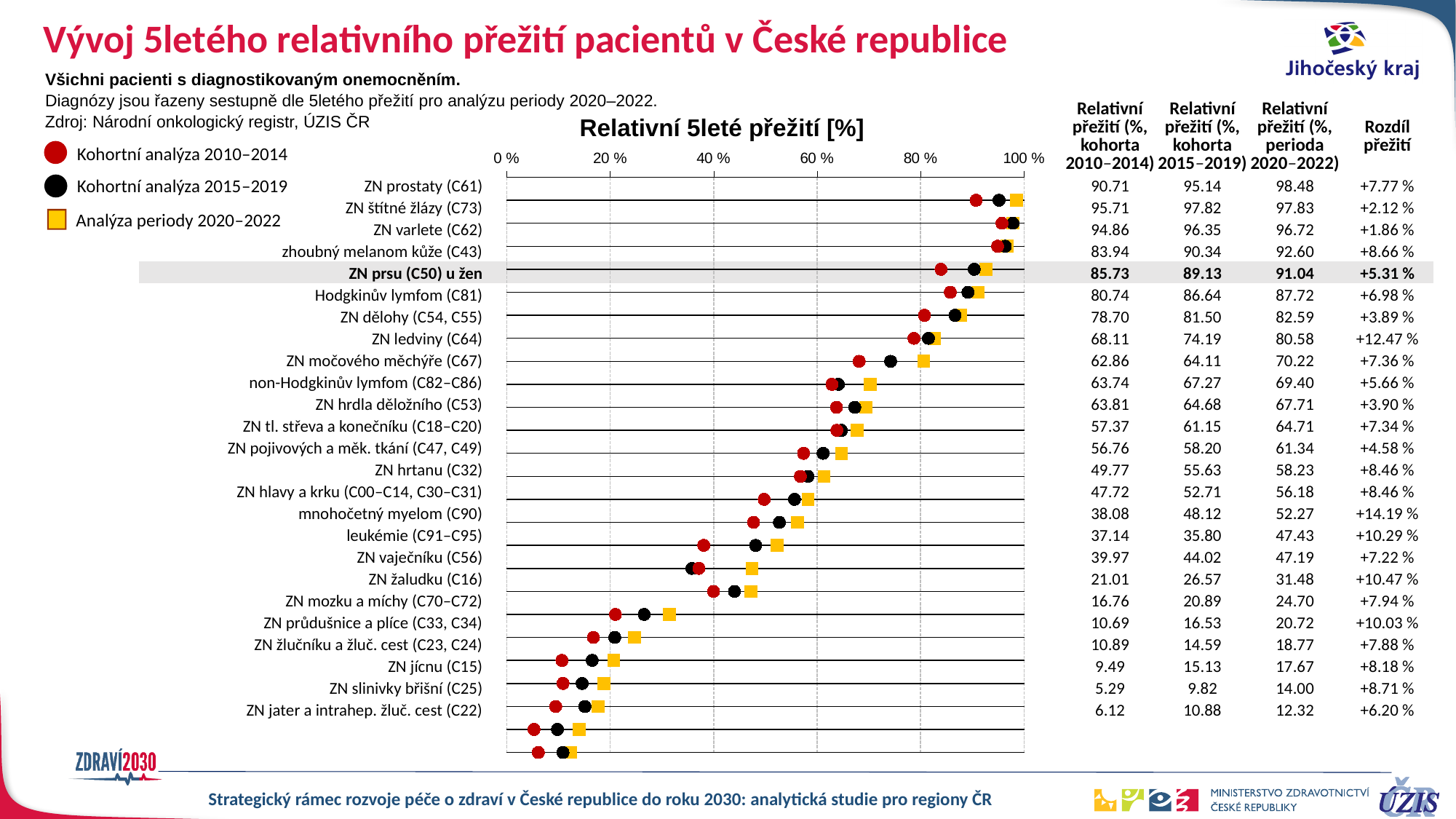
Which diagnosis has the highest relative 5-year survival in the period analysis 2020–2022? ZN prostaty (C61) Which is larger: the 2020–2022 period survival for ZN ledviny (C64) or for ZN močového měchýře (C67)? ZN ledviny (C64) How many series does the legend list? 3 Which diagnosis has the lowest relative 5-year survival in the period analysis 2020–2022? ZN jater a intrahep. žluč. cest (C22) What is the relative 5-year survival for leukémie (C91–C95) in the cohort analysis 2015–2019? 35.80 What is the difference in survival (Rozdíl přežití) shown for mnohočetný myelom (C90)? +14.19 % What is the relative 5-year survival for ZN prostaty (C61) in the period analysis 2020–2022? 98.48 What is the relative 5-year survival for ZN prsu (C50) u žen in the cohort analysis 2010–2014? 85.73 What kind of chart is shown? dot plot How many diagnoses are plotted in the chart? 25 Is the 2020–2022 period survival for ZN žaludku (C16) greater or less than 40 %? less What is the title of the chart? Relativní 5leté přežití [%]